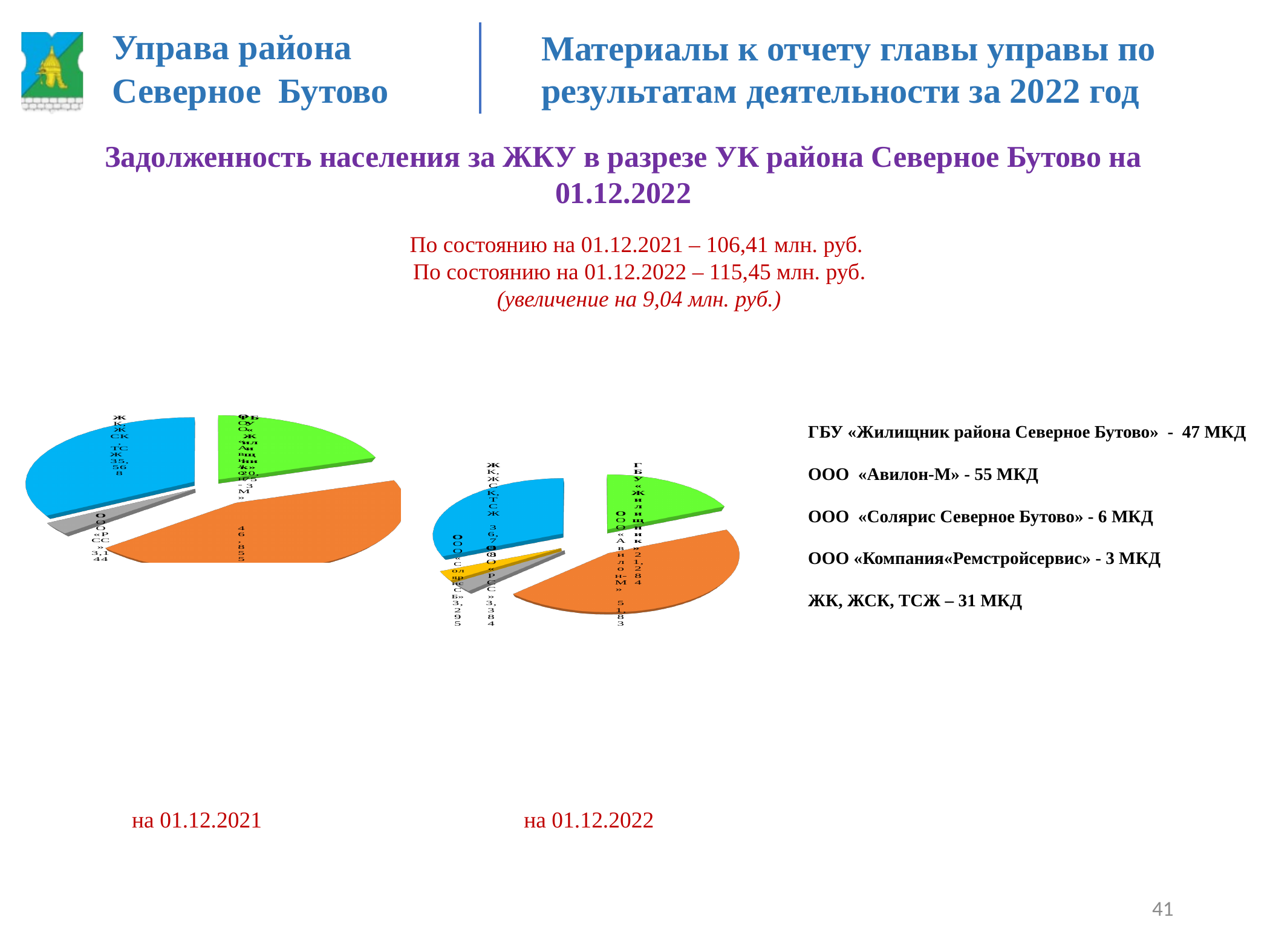
In the pie chart for на 01.12.2021, which slice is the smallest? ООО «РСС» (3,144) How many slices does the pie chart for на 01.12.2022 have? 5 What kind of chart is shown for на 01.12.2022? pie chart How many slices does the pie chart for на 01.12.2021 have? 4 In the pie chart for на 01.12.2021, which slice is the largest? the orange slice (46,855) What kind of chart is shown for на 01.12.2021? pie chart In the pie chart for на 01.12.2022, what value is shown for ООО «РСС»? 3,384 In the pie chart for на 01.12.2022, what value is shown for ГБУ «Жилищник»? 21,284 In the pie chart for на 01.12.2021, what value is shown for ООО «РСС»? 3,144 In the pie chart for на 01.12.2021, what value is shown on the orange slice? 46,855 In the pie chart for на 01.12.2022, which slice is the largest? the orange slice (ООО «Авилон-М») How many pie charts are on the slide? 2